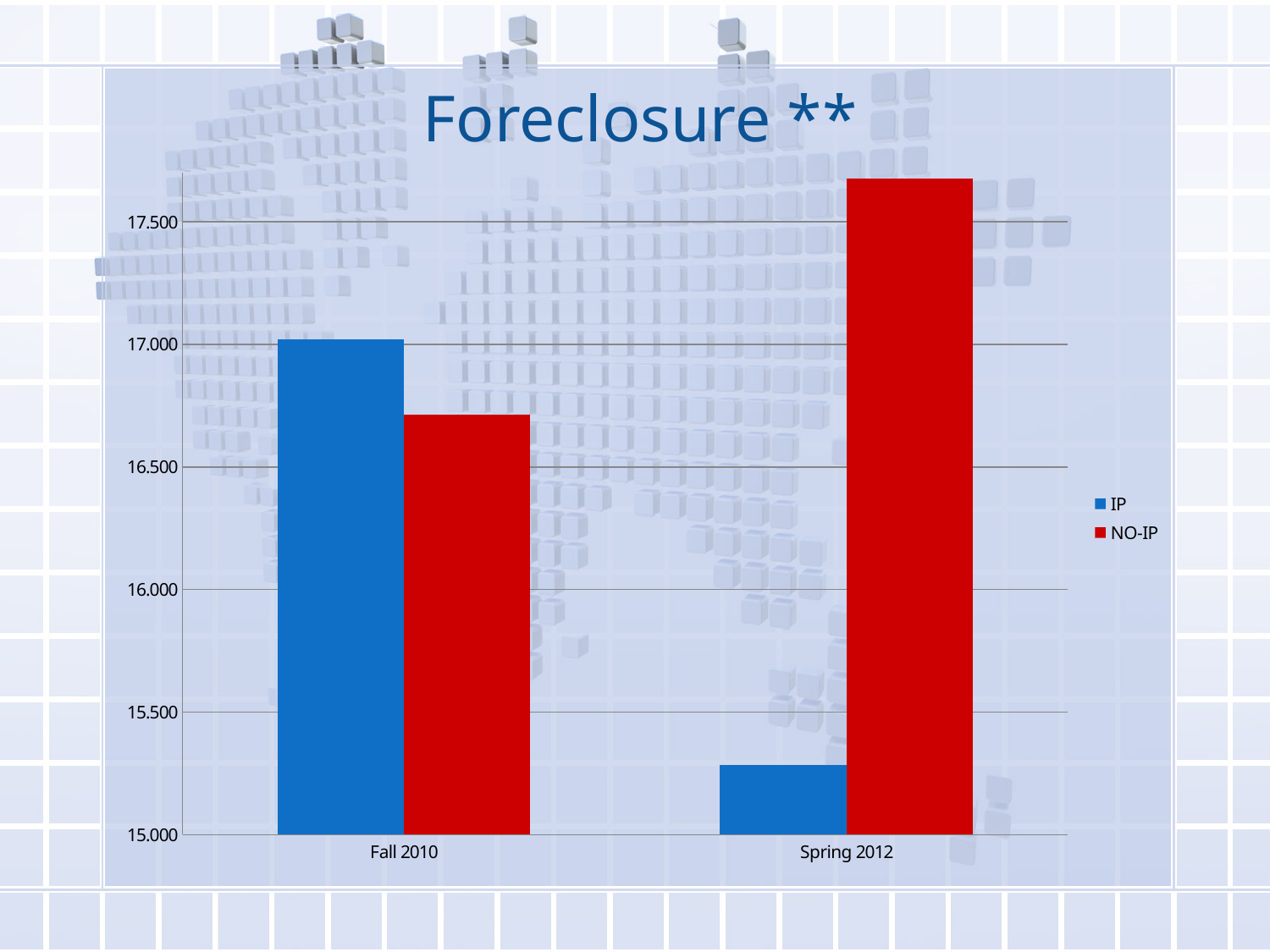
In Fall 2010, which series has the larger value, IP or NO-IP? IP What kind of chart is shown on the slide? bar chart Which series is shown in red? NO-IP How many series does the legend list? 2 Is the value for NO-IP in Spring 2012 greater or less than 17.500? greater In Spring 2012, which series has the larger value, IP or NO-IP? NO-IP How many categories are shown on the x axis? 2 Which bar is the shortest in the chart? IP in Spring 2012 Is the value for IP in Spring 2012 greater or less than 15.500? less Does the IP series rise or fall from Fall 2010 to Spring 2012? fall Which bar is the tallest in the chart? NO-IP in Spring 2012 What is the title of the chart? Foreclosure **